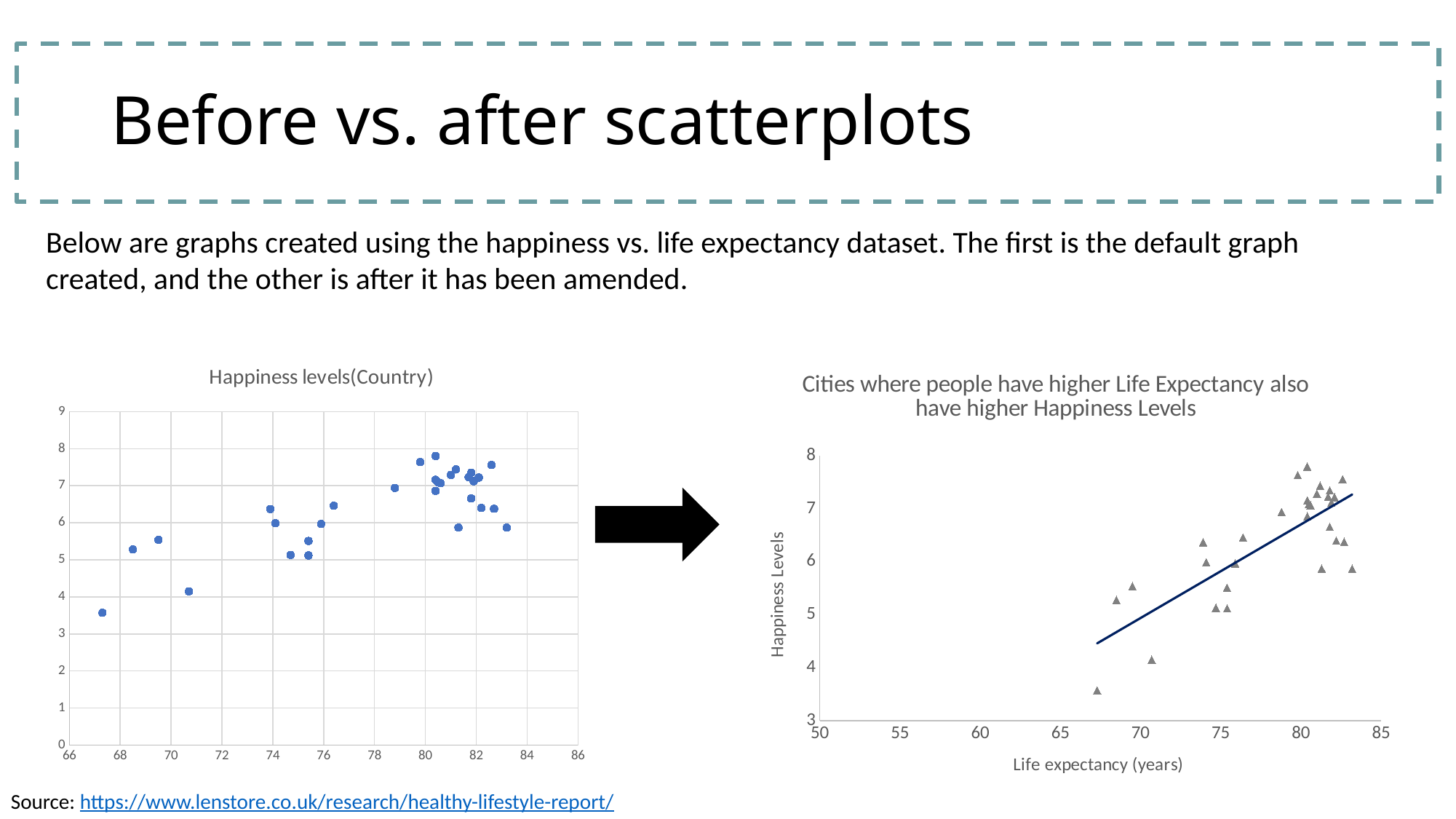
In the right chart, is the highest plotted happiness level greater or less than 7? greater What kind of chart is the left chart titled "Happiness levels(Country)"? scatter plot In the left chart "Happiness levels(Country)", do the happiness values generally rise or fall as you move from left to right along the x axis? rise In the left chart "Happiness levels(Country)", is the highest plotted happiness value greater or less than 8? less In the right chart, do happiness levels generally rise or fall as life expectancy increases along the x axis? rise In the right chart, is the lowest plotted happiness level greater or less than 4? less What is the x-axis label of the right chart? Life expectancy (years) What is the y-axis label of the right chart? Happiness Levels What kind of chart is the right chart, "Cities where people have higher Life Expectancy also have higher Happiness Levels"? scatter plot